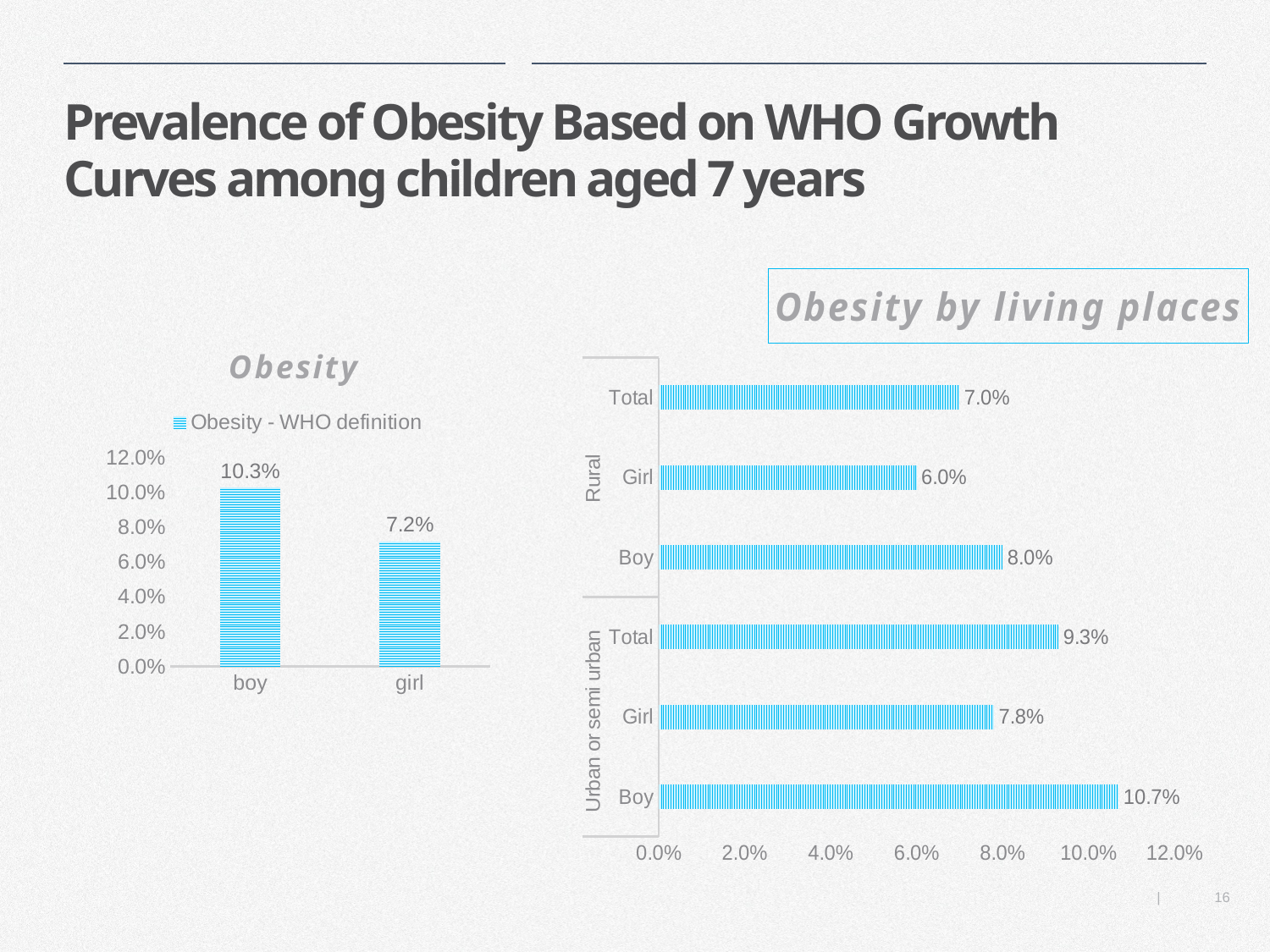
In the 'Obesity' chart, what is the value for girl? 7.2% In the 'Obesity' chart, what series name does the legend show? Obesity - WHO definition In the 'Obesity by living places' chart, what is the value for Rural Girl? 6.0% In the 'Obesity by living places' chart, what is the value for Rural Total? 7.0% In the 'Obesity by living places' chart, what is the value for Urban or semi urban Boy? 10.7% What kind of chart is the 'Obesity by living places' chart? bar chart In the 'Obesity by living places' chart, which is larger: Rural Boy or Urban or semi urban Girl? Rural Boy In the 'Obesity' chart, what is the value for boy? 10.3% In the 'Obesity by living places' chart, what is the difference between the Urban or semi urban Total and the Rural Total? 2.3% In the 'Obesity' chart, what is the difference between the boy and girl values? 3.1% In the 'Obesity by living places' chart, which category has the highest value? Urban or semi urban Boy In the 'Obesity by living places' chart, which category has the lowest value? Rural Girl